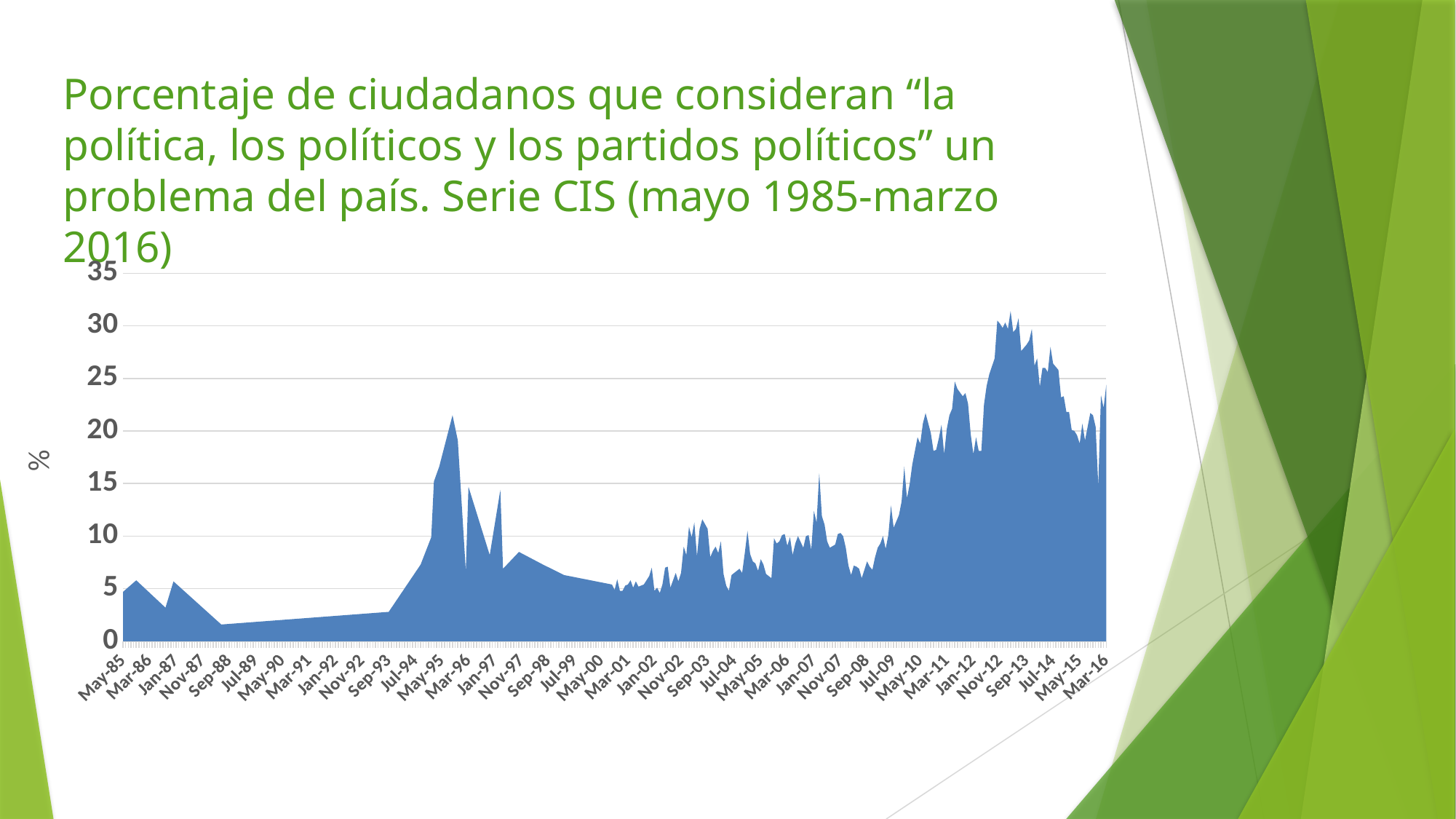
What is the first date label on the horizontal axis? May-85 What is the label on the vertical axis of the chart? % Is the value for Jul-99 greater or less than 10? less Is the value for Nov-12 greater or less than 25? greater Which has the larger value, Mar-16 or Sep-88? Mar-16 Overall, do the values rise or fall from May-85 to Mar-16? rise Which has the larger value, May-95 or Jul-99? May-95 Is the value for Mar-16 greater or less than 20? greater What kind of chart is shown on the slide? area chart Which has the larger value, Nov-12 or May-85? Nov-12